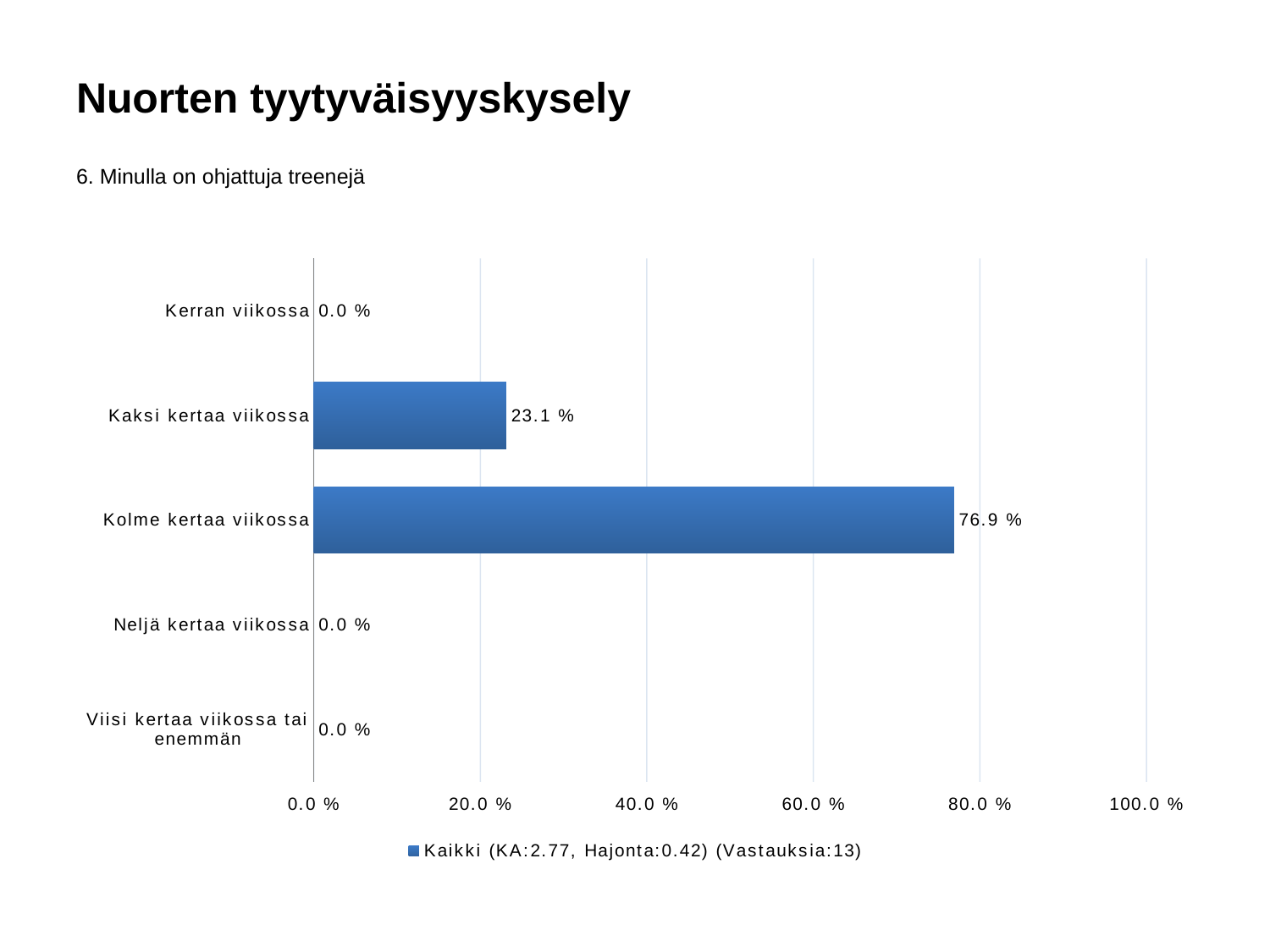
Which is larger, the value for Kaksi kertaa viikossa or the value for Neljä kertaa viikossa? Kaksi kertaa viikossa How many categories are shown on the chart? 5 How many series does the legend list? 1 How many categories have a value of 0.0 %? 3 What is the value for Kerran viikossa? 0.0 % What is the value for Kaksi kertaa viikossa? 23.1 % Which category has the highest value? Kolme kertaa viikossa What is the value for Kolme kertaa viikossa? 76.9 % What kind of chart is shown on the slide? bar chart What is the difference between the values for Kolme kertaa viikossa and Kaksi kertaa viikossa? 53.8 % What is the survey question shown above the chart? 6. Minulla on ohjattuja treenejä Is the value for Kolme kertaa viikossa greater or less than 60.0 %? greater